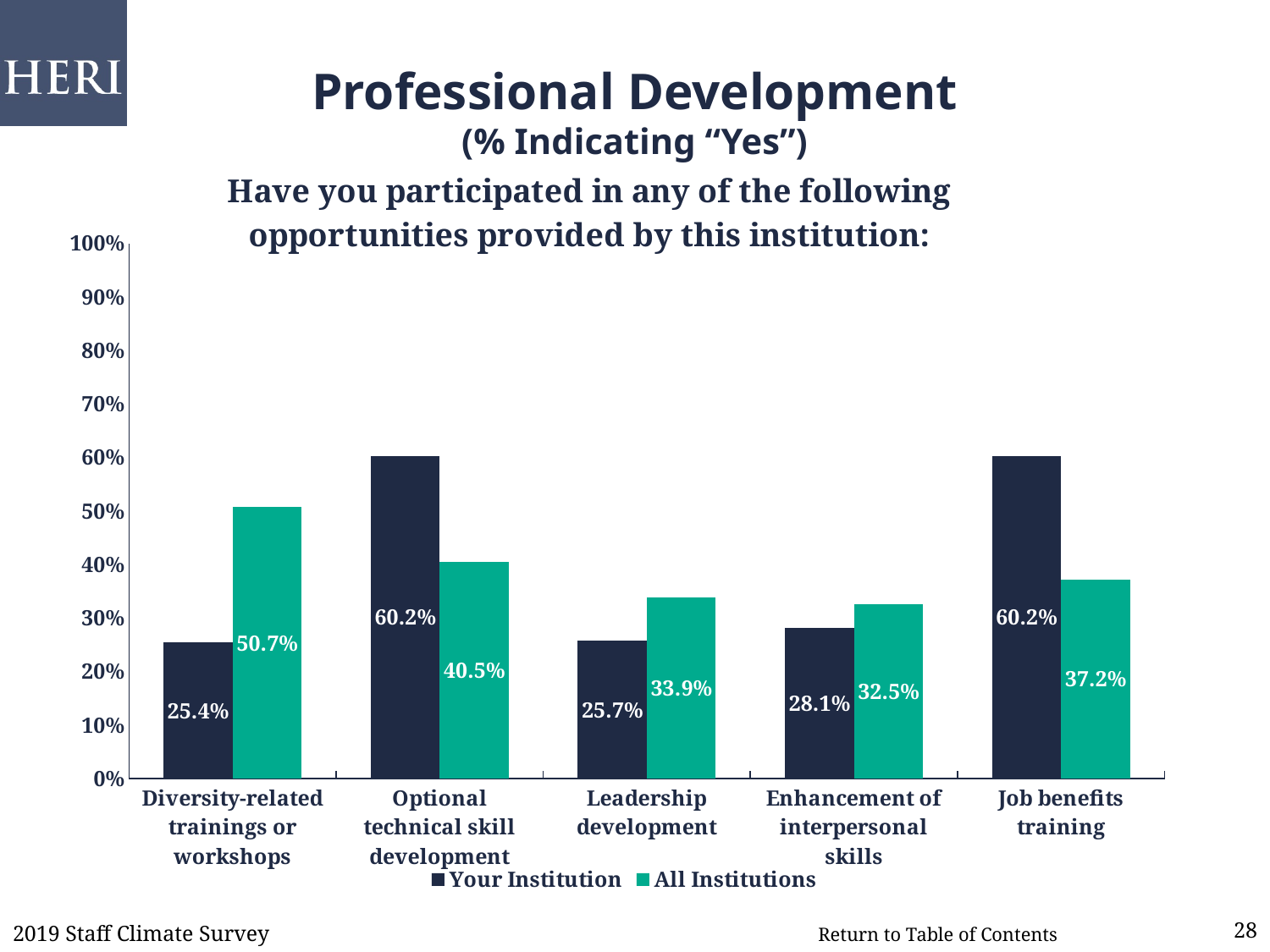
What percentage of respondents at Your Institution indicated they participated in diversity-related trainings or workshops? 25.4% What kind of chart is shown on the slide? Bar chart What is the Your Institution value for optional technical skill development? 60.2% How many categories are shown on the x axis? 5 What is the All Institutions value for job benefits training? 37.2% For leadership development, which is larger: the Your Institution value or the All Institutions value? All Institutions What is the All Institutions value for enhancement of interpersonal skills? 32.5% Which category has the highest All Institutions value? Diversity-related trainings or workshops How many series does the legend list? 2 Which category has the lowest All Institutions value? Enhancement of interpersonal skills What is the difference between the All Institutions and Your Institution values for diversity-related trainings or workshops? 25.3 percentage points What is the difference between the Your Institution and All Institutions values for job benefits training? 23.0 percentage points